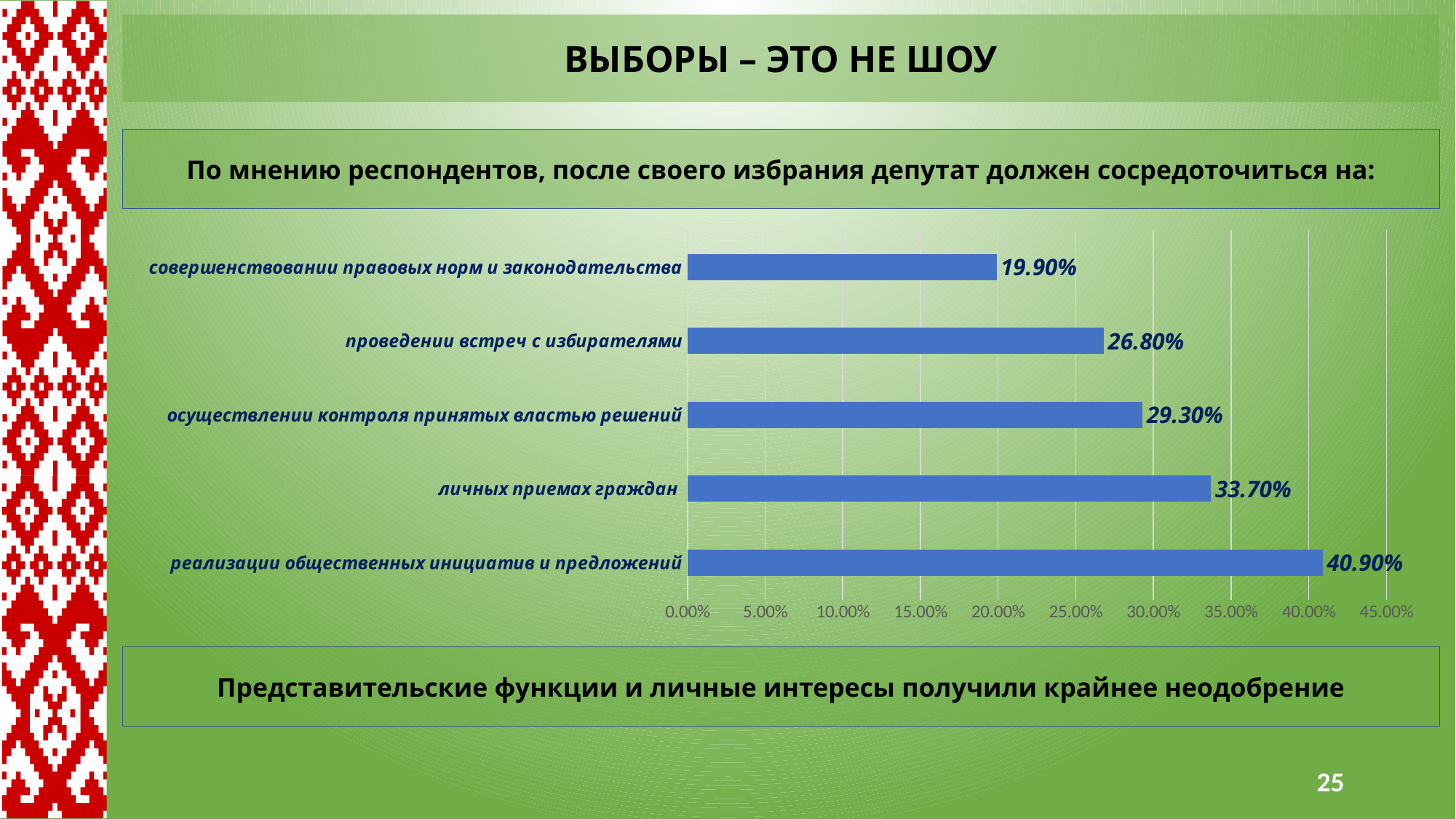
What is the value for 'совершенствовании правовых норм и законодательства'? 19.90% Which is larger: the value for 'осуществлении контроля принятых властью решений' or for 'проведении встреч с избирателями'? осуществлении контроля принятых властью решений What is the difference between the values for 'реализации общественных инициатив и предложений' and 'личных приемах граждан'? 7.20% What is the maximum value shown on the x axis? 45.00% Which category has the highest value? реализации общественных инициатив и предложений Which category has the lowest value? совершенствовании правовых норм и законодательства Is the value for 'осуществлении контроля принятых властью решений' greater or less than 25.00%? greater What is the value for 'личных приемах граждан'? 33.70% What is the value for 'проведении встреч с избирателями'? 26.80% What kind of chart is shown on the slide? bar chart How many categories are shown in the chart? 5 What is the value for 'реализации общественных инициатив и предложений'? 40.90%